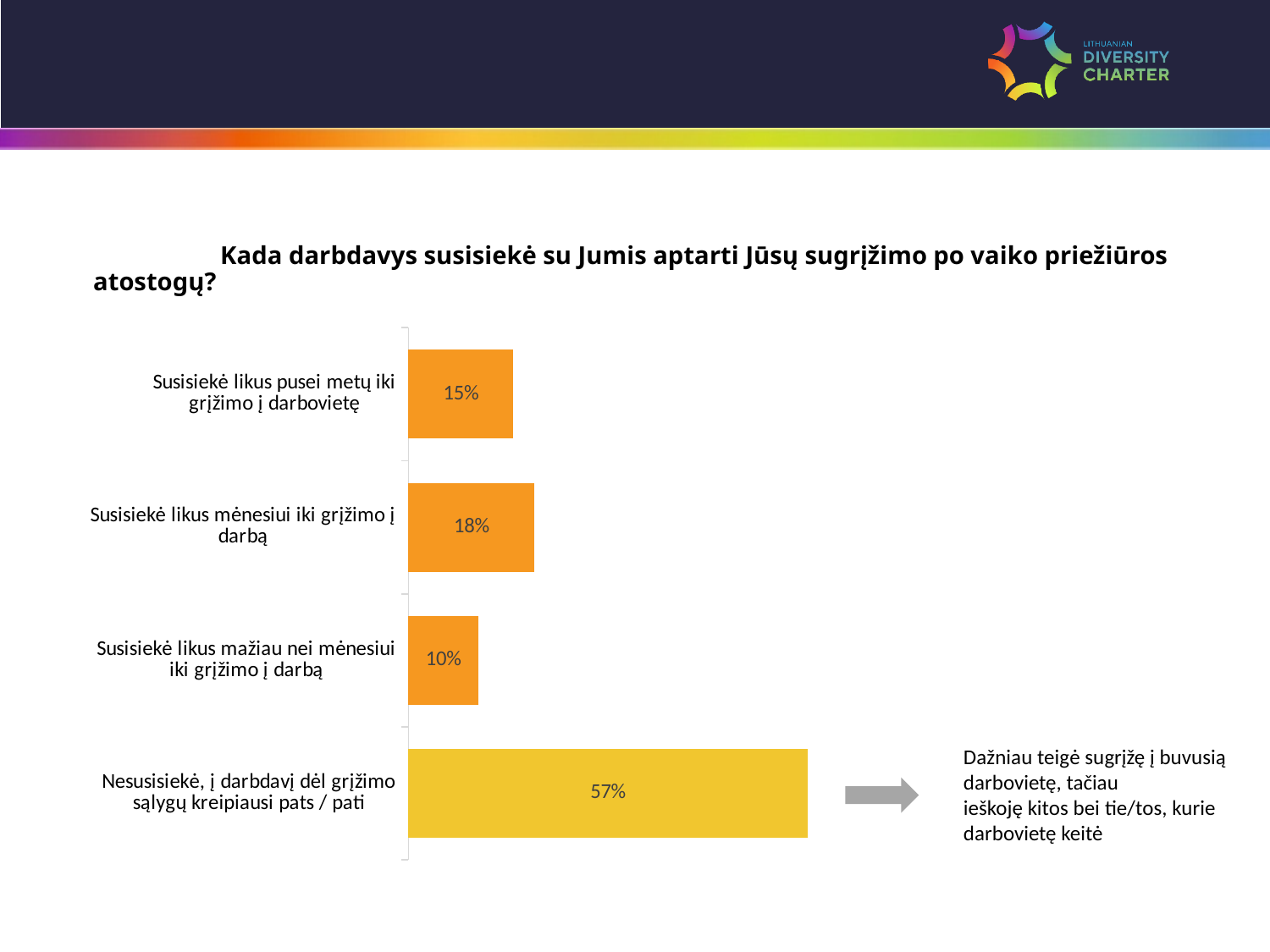
Which category has the lowest value? Susisiekė likus mažiau nei mėnesiui iki grįžimo į darbą Which is larger: the value for "Susisiekė likus pusei metų iki grįžimo į darbovietę" or for "Susisiekė likus mėnesiui iki grįžimo į darbą"? Susisiekė likus mėnesiui iki grįžimo į darbą What kind of chart is shown on the slide? Bar chart Which category has the highest value? Nesusisiekė, į darbdavį dėl grįžimo sąlygų kreipiausi pats / pati What is the difference between the values for "Susisiekė likus mėnesiui iki grįžimo į darbą" and "Susisiekė likus pusei metų iki grįžimo į darbovietę"? 3% What is the value for "Nesusisiekė, į darbdavį dėl grįžimo sąlygų kreipiausi pats / pati"? 57% What is the value for "Susisiekė likus pusei metų iki grįžimo į darbovietę"? 15% What is the value for "Susisiekė likus mažiau nei mėnesiui iki grįžimo į darbą"? 10% How many categories are shown in the chart? 4 What is the title of the chart? Kada darbdavys susisiekė su Jumis aptarti Jūsų sugrįžimo po vaiko priežiūros atostogų? What is the value for "Susisiekė likus mėnesiui iki grįžimo į darbą"? 18% What is the difference between the values for "Nesusisiekė, į darbdavį dėl grįžimo sąlygų kreipiausi pats / pati" and "Susisiekė likus mažiau nei mėnesiui iki grįžimo į darbą"? 47%